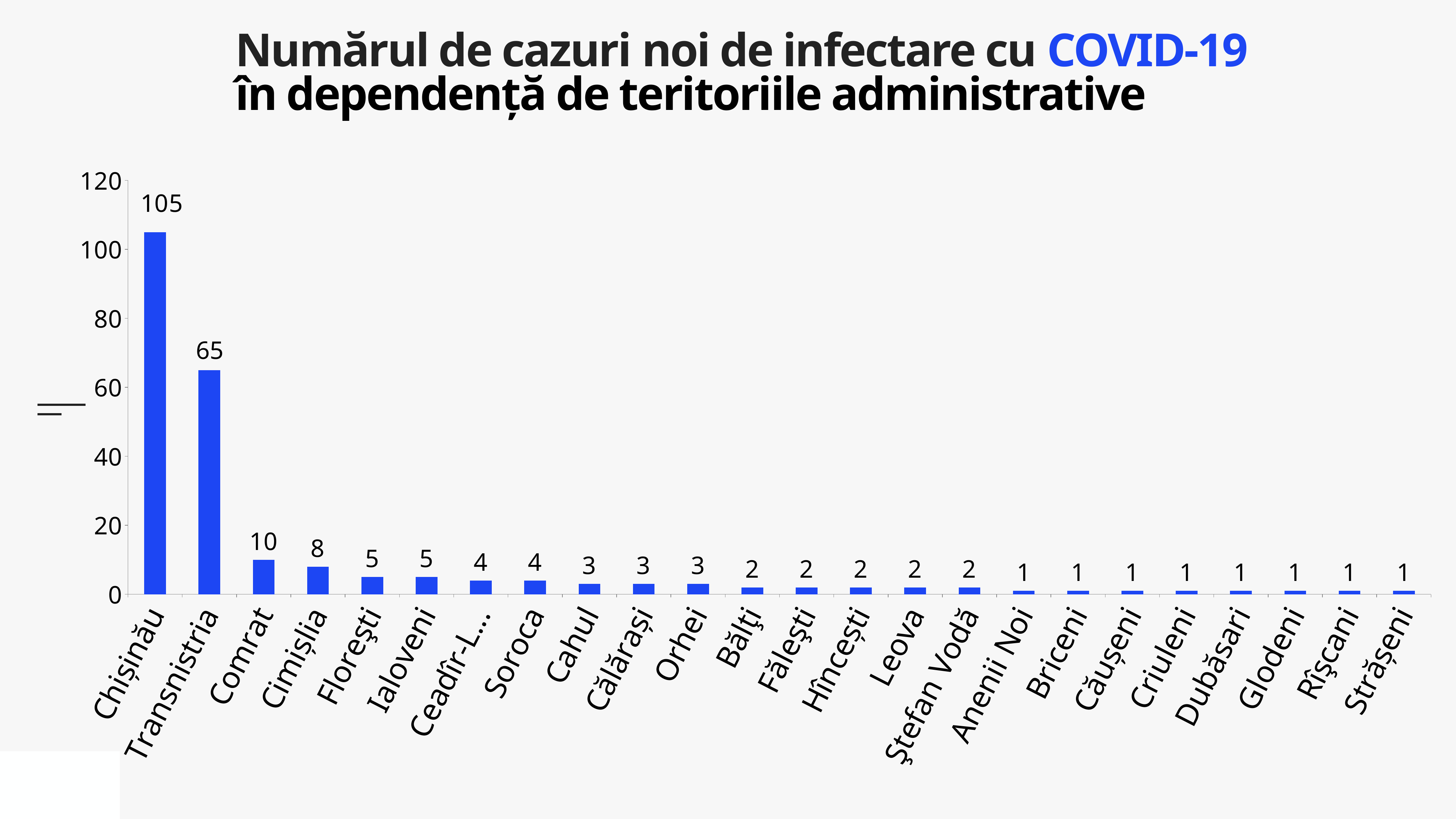
Which territory has the highest number of new cases? Chișinău Which has a larger value, Transnistria or Comrat? Transnistria What is the difference between the values for Chișinău and Transnistria? 40 Do the values rise or fall from left to right along the x axis? Fall What is the number of new cases shown for Transnistria? 65 How many territories are shown on the x axis? 24 Is the value for Chișinău greater or less than 100? greater What is the difference between the values for Comrat and Cimișlia? 2 What value is shown for Comrat? 10 What is the number of new COVID-19 cases for Chișinău? 105 What kind of chart is shown on the slide? Bar chart What value is shown for Cimișlia? 8